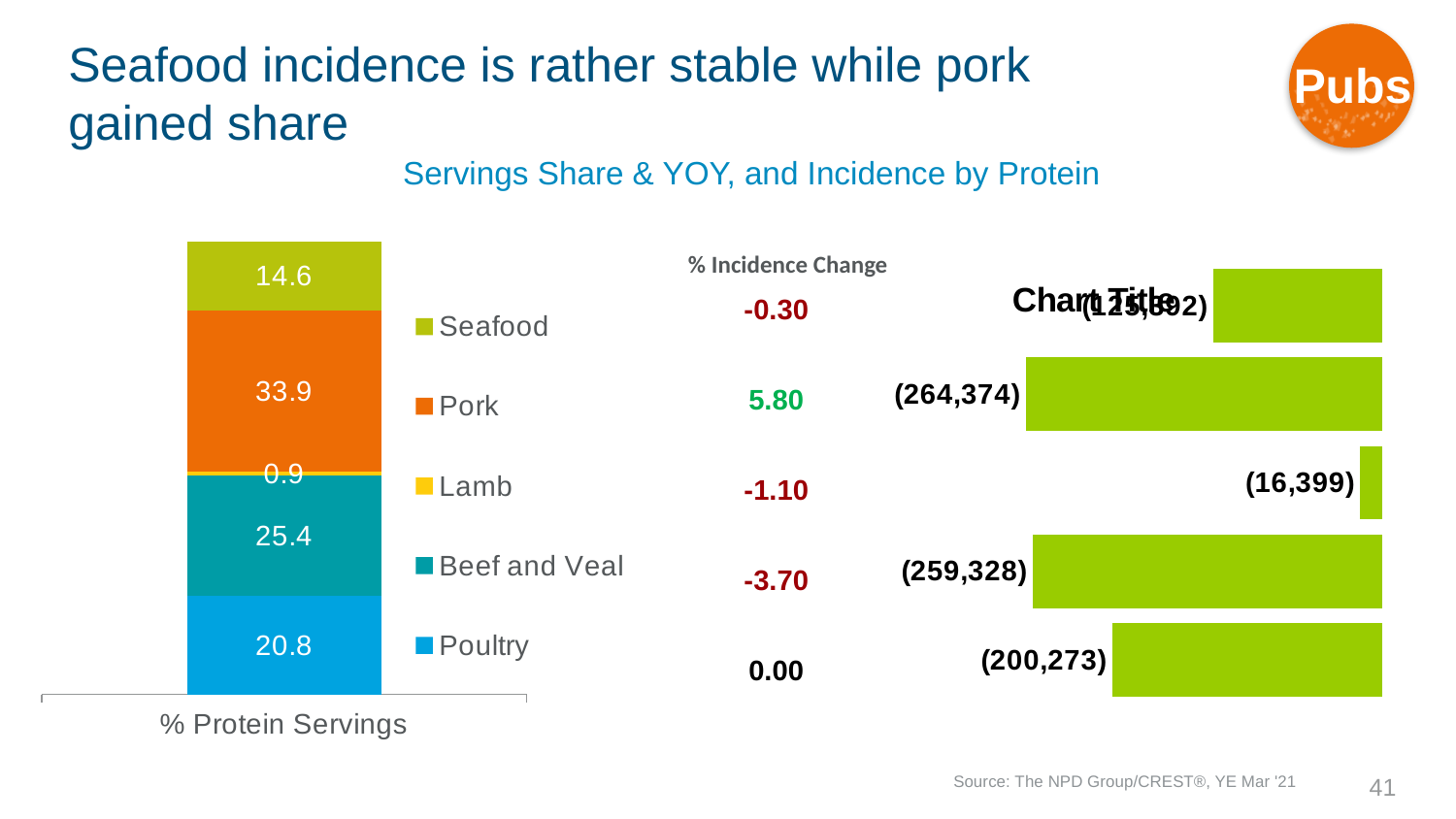
In the stacked bar chart on the left (% Protein Servings), what is the value for Poultry? 20.8 In the stacked bar chart on the left (% Protein Servings), what is the value for Beef and Veal? 25.4 In the stacked bar chart on the left (% Protein Servings), what is the difference between the Pork and Beef and Veal values? 8.5 In the stacked bar chart on the left (% Protein Servings), what is the value for Lamb? 0.9 What kind of chart is the chart on the left labelled % Protein Servings? Stacked bar chart In the stacked bar chart on the left (% Protein Servings), what is the value for Pork? 33.9 In the stacked bar chart on the left (% Protein Servings), which protein has the largest share? Pork How many series does the legend of the stacked bar chart on the left list? 5 In the stacked bar chart on the left (% Protein Servings), what is the value for Seafood? 14.6 In the horizontal bar chart on the right, what is the data label on the shortest bar? (16,399) In the stacked bar chart on the left (% Protein Servings), which protein has the smallest share? Lamb In the stacked bar chart on the left (% Protein Servings), which is larger, Beef and Veal or Poultry? Beef and Veal